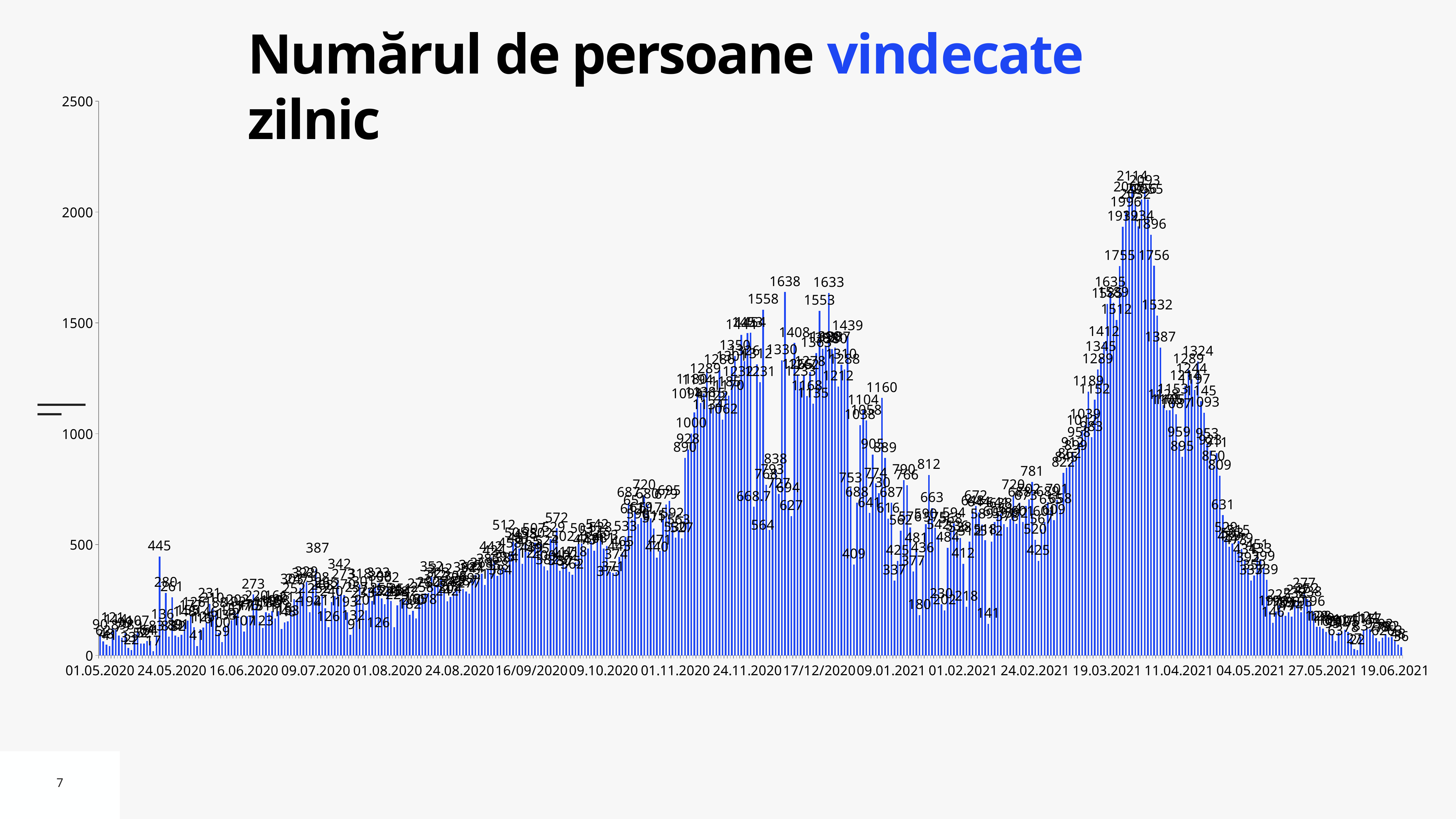
Is the value on 19.06.2021 greater or less than 500? less What is the highest value labeled on the chart? 2114 What kind of chart is shown on the slide? bar chart What is the highest value labeled in the peak around 24.11.2020? 1638 Between 11.04.2021 and 19.06.2021, do the values generally rise or fall? fall What is the title of the chart? Numărul de persoane vindecate zilnic What is the difference between the overall peak value (2114) and the November 2020 peak value (1638)? 476 What is the maximum value shown on the vertical axis? 2500 Which peak is higher: the one around 24.11.2020 or the one around 11.04.2021? the one around 11.04.2021 Is the peak value around 11.04.2021 greater or less than 2000? greater Is the value on 01.05.2020 greater or less than 500? less